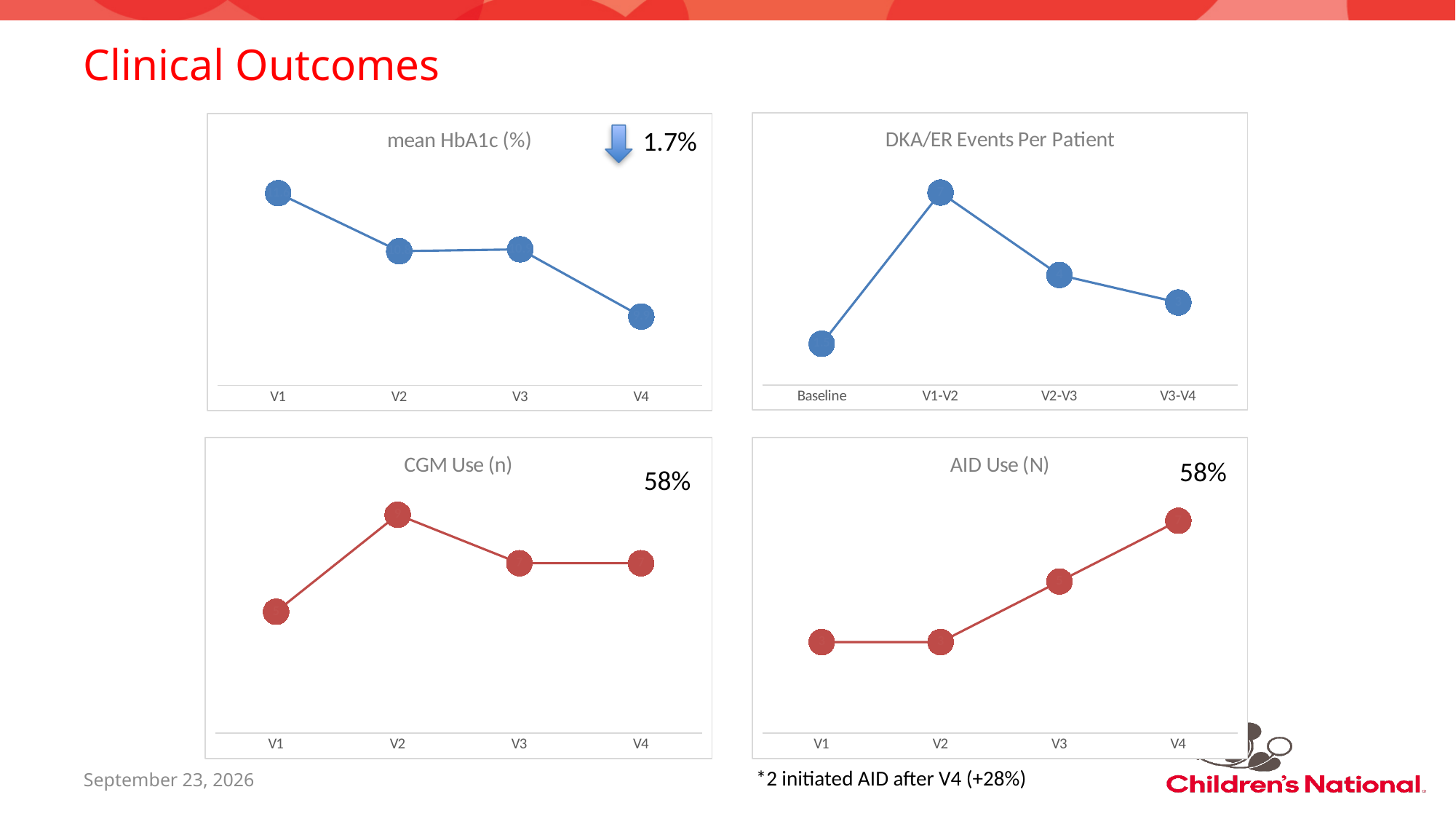
In the "CGM Use (n)" chart, which visit has the lowest value? V1 What kind of chart is the "mean HbA1c (%)" chart? line chart In the "AID Use (N)" chart, which visit has the highest value? V4 How many data points are plotted in the "mean HbA1c (%)" chart? 4 What percentage is shown next to the downward arrow in the "mean HbA1c (%)" chart? 1.7% In the "DKA/ER Events Per Patient" chart, which category has the lowest value? Baseline In the "mean HbA1c (%)" chart, which visit has the highest value? V1 In the "CGM Use (n)" chart, which visit has the highest value? V2 In the "mean HbA1c (%)" chart, which visit has the lowest value? V4 In the "AID Use (N)" chart, do the values rise or fall from V1 to V4? rise In the "DKA/ER Events Per Patient" chart, which is larger, the value for V2-V3 or for V3-V4? V2-V3